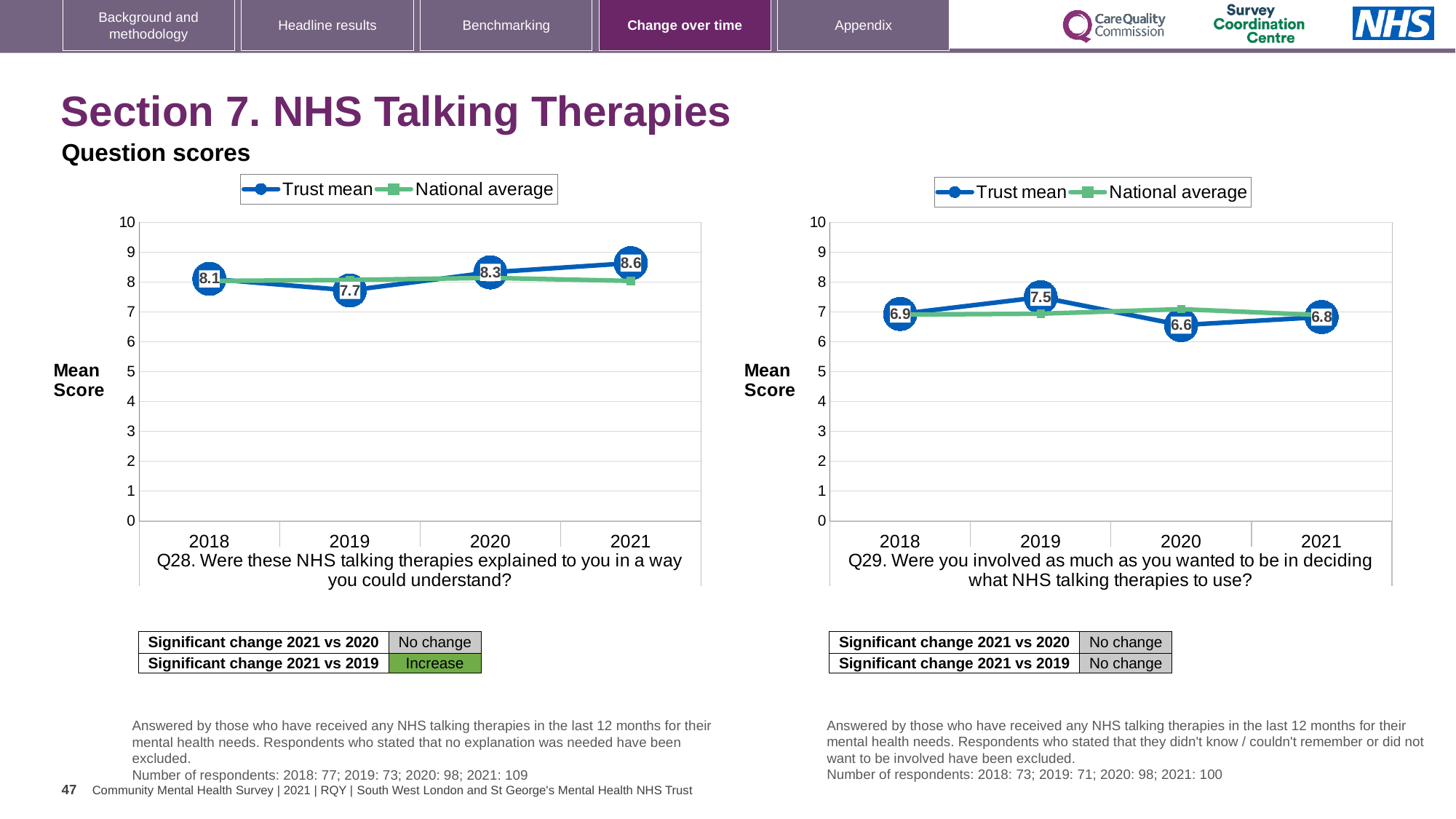
How many series does the legend of the Q29 chart (right) list? 2 In the Q28 chart (left), what is the Trust mean score for 2021? 8.6 In the Q28 chart (left), what is the Trust mean score for 2019? 7.7 In the Q29 chart (right), what is the Trust mean score for 2020? 6.6 In the Q28 chart (left), which year has the lowest Trust mean score? 2019 How many years are shown on the x axis of the Q28 chart (left)? 4 In the Q29 chart (right), which year has the highest Trust mean score? 2019 In the Q28 chart (left), what is the difference between the Trust mean scores for 2021 and 2019? 0.9 In the Q29 chart (right), which is larger, the Trust mean for 2018 or for 2020? 2018 In the Q28 chart (left), does the Trust mean rise or fall from 2019 to 2021? Rise In the Q29 chart (right), is the National average for 2020 greater or less than 6? greater What kind of chart is the Q28 chart (left)? Line chart